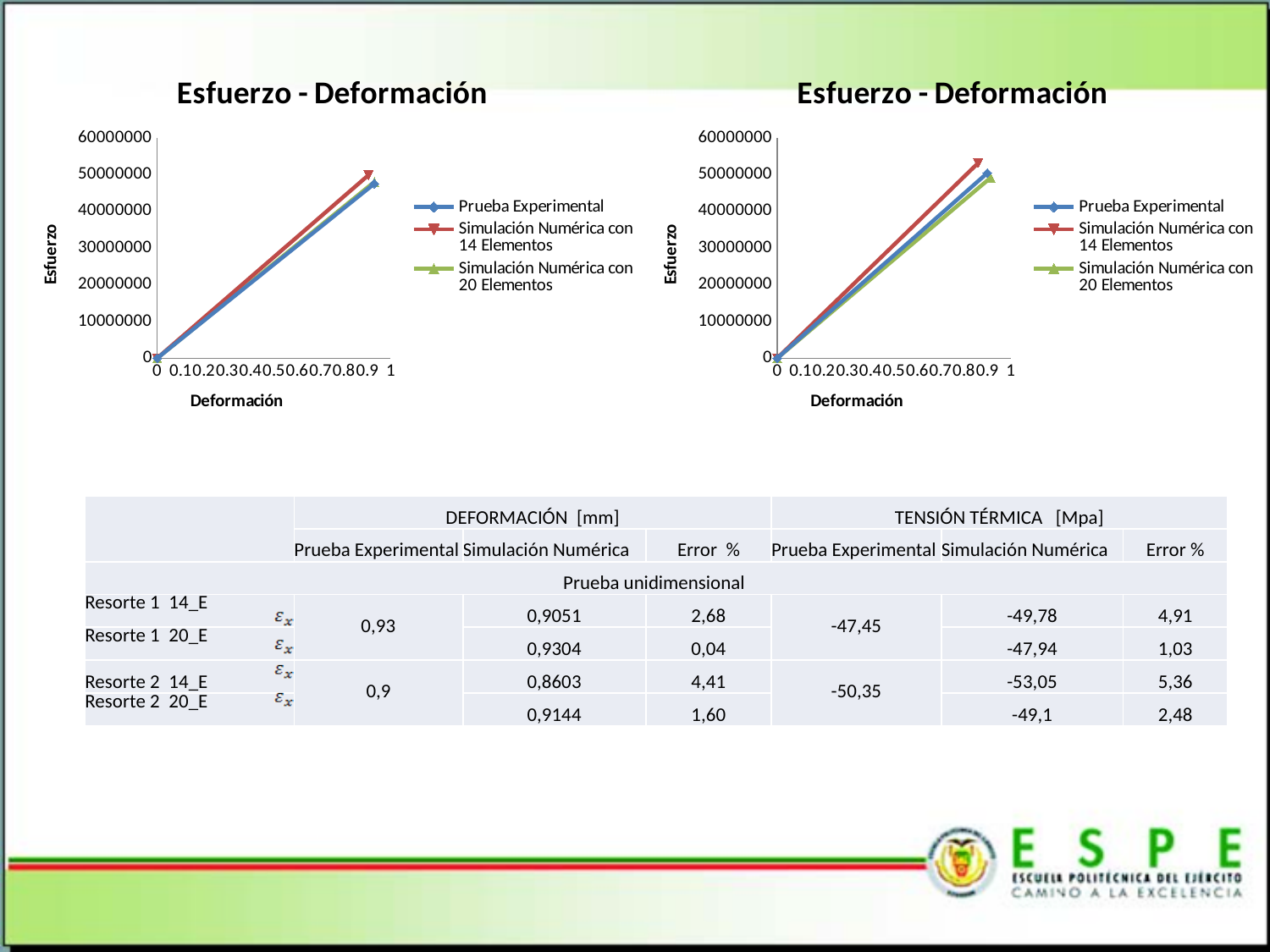
In the right chart, do the values of Simulación Numérica con 20 Elementos rise or fall along the x axis? Rise In the right chart, at the right end of the x axis, which is larger: Simulación Numérica con 14 Elementos or Simulación Numérica con 20 Elementos? Simulación Numérica con 14 Elementos In the left chart, is the value of Simulación Numérica con 14 Elementos at the right end of the x axis greater or less than 30000000? greater What is the label of the x axis of the right chart? Deformación What is the title of the left chart? Esfuerzo - Deformación In the left chart, do the values of Prueba Experimental rise or fall as Deformación increases? Rise What kind of chart is the left chart on the slide? Line chart How many series does the legend of the right chart list? 3 In the left chart, is the final value of Prueba Experimental greater or less than 60000000? less In the left chart, which series reaches the highest Esfuerzo value at the right end of the x axis? Simulación Numérica con 14 Elementos In the right chart, which series reaches the highest Esfuerzo value at the right end of the x axis? Simulación Numérica con 14 Elementos In the right chart, is the final value of Simulación Numérica con 14 Elementos greater or less than 40000000? greater